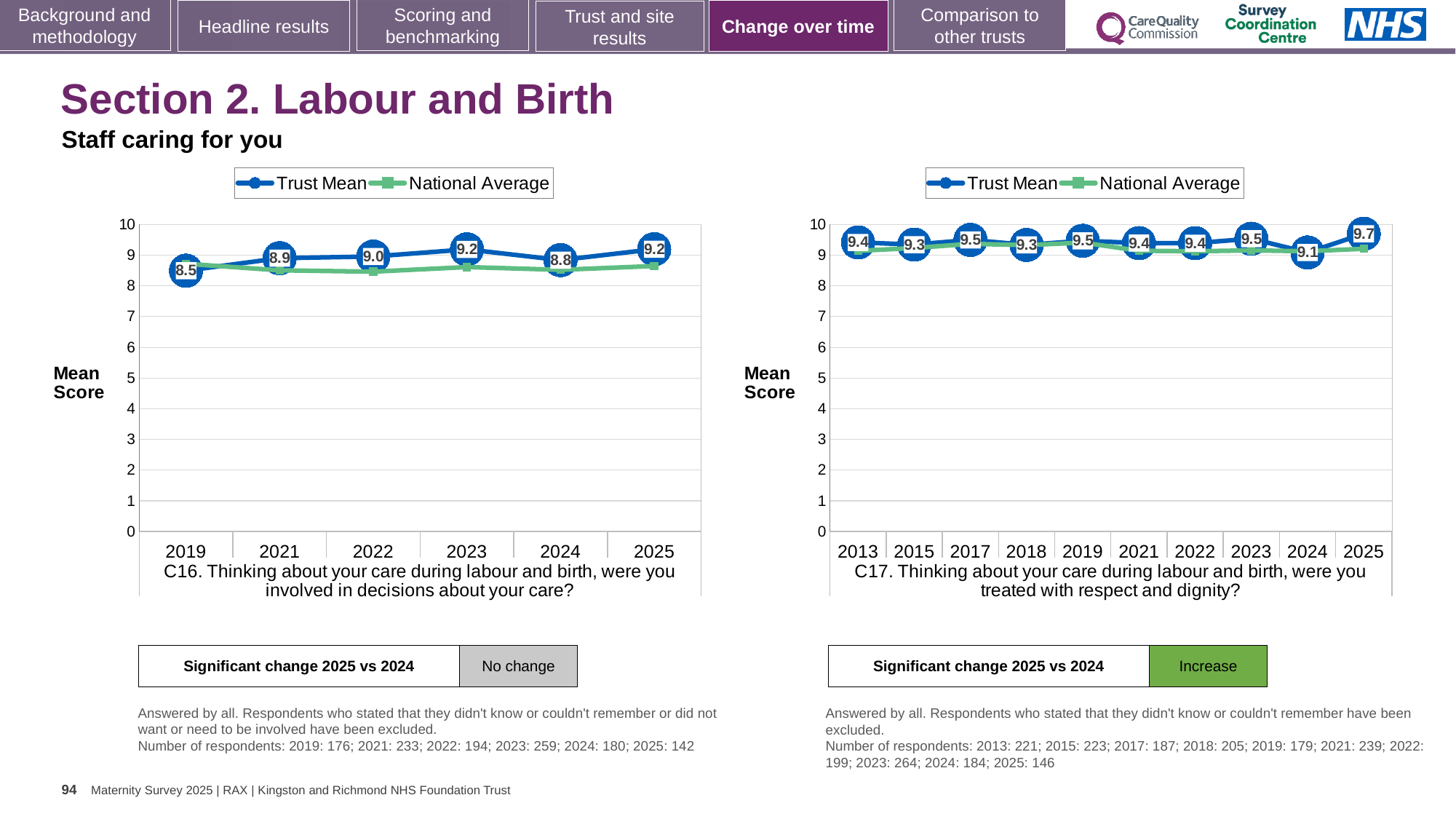
What type of chart is the C16 chart on the left? Line chart In the C17 chart (right), which year has the highest Trust Mean score? 2025 In the C17 chart (right), what is the Trust Mean score for 2025? 9.7 In the C17 chart (right), what is the Trust Mean score for 2024? 9.1 In the C16 chart (left), how many years are plotted on the x axis? 6 In the C17 chart (right), which year has the lowest Trust Mean score? 2024 In the C16 chart (left), what is the Trust Mean score for 2019? 8.5 In the C17 chart (right), what is the difference between the Trust Mean scores for 2025 and 2024? 0.6 In the C17 chart (right), how many series does the legend list? 2 In the C16 chart (left), what is the difference between the Trust Mean scores for 2025 and 2019? 0.7 In the C16 chart (left), what is the Trust Mean score for 2024? 8.8 In the C16 chart (left), which year has the lowest Trust Mean score? 2019